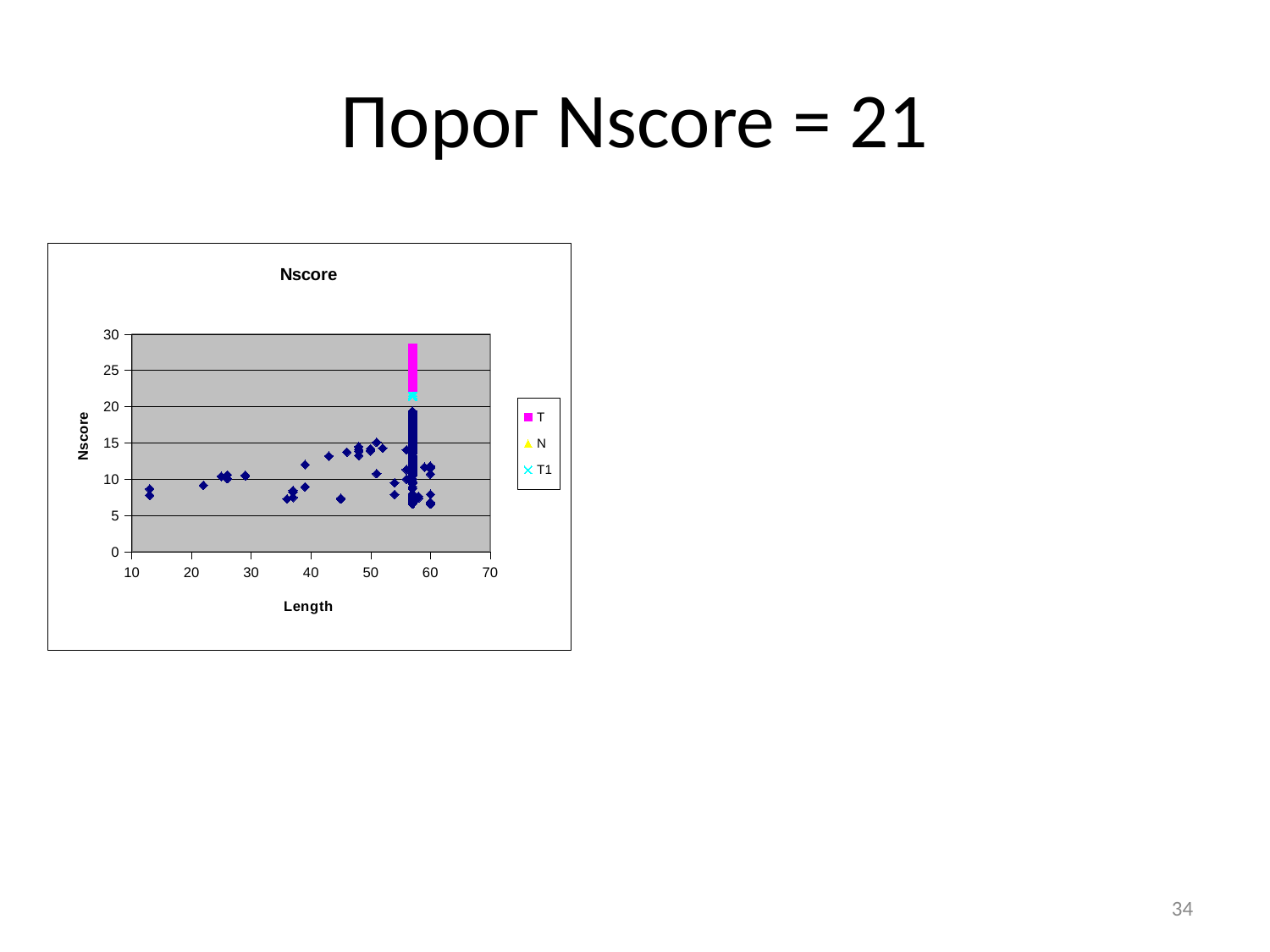
What kind of chart is shown on the slide? scatter chart Are the magenta T points greater or less than 30 on the Nscore axis? less Is the blue point at Length about 22 greater or less than 15 on the Nscore axis? less Are the blue points at Length about 13 greater or less than 10 on the Nscore axis? less What is the title of the chart? Nscore How many series does the legend of the chart list? 3 Which series in the chart has the highest Nscore values, T or N? T What is the label of the horizontal axis of the chart? Length